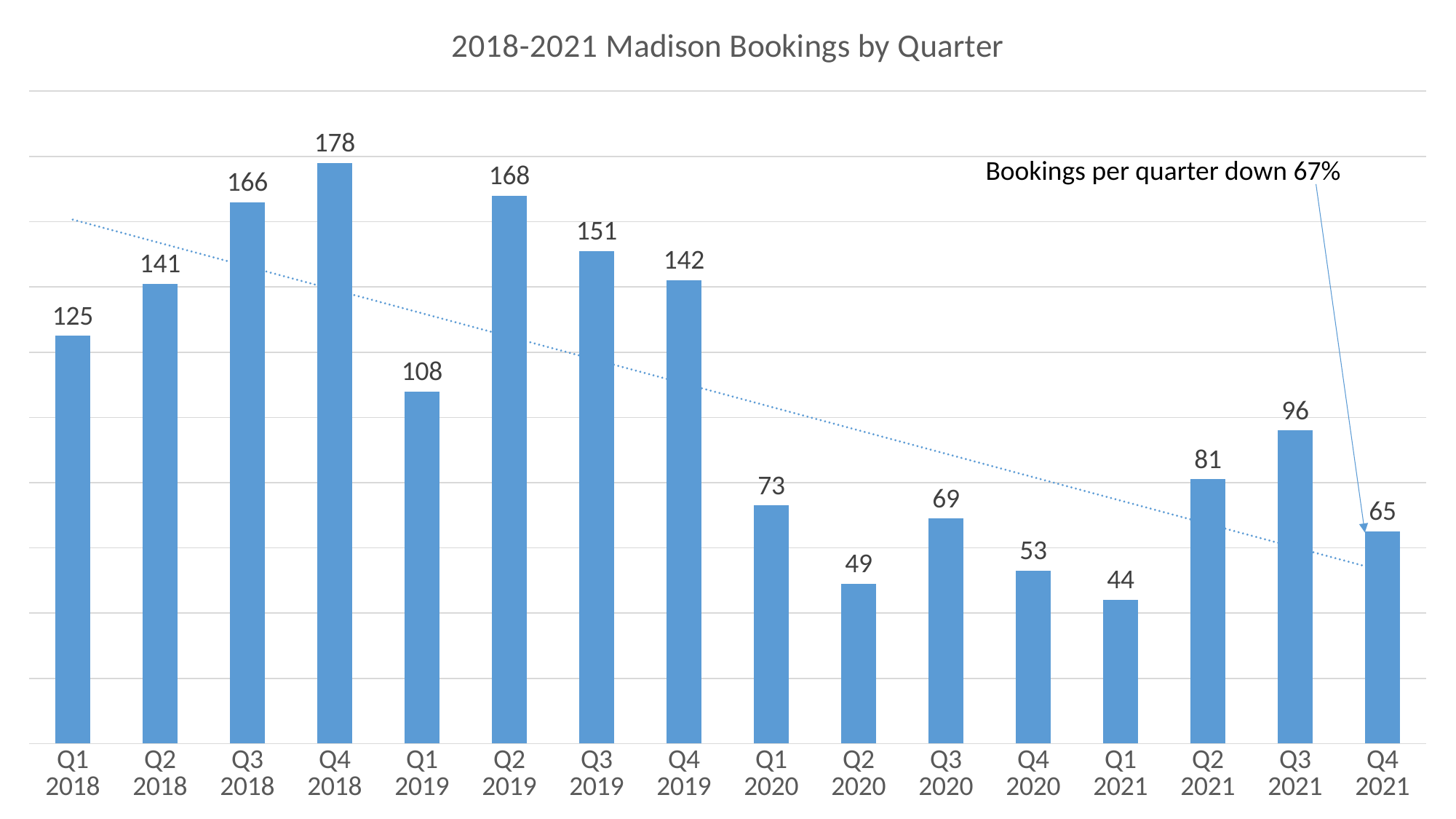
What is the difference between the bookings in Q4 2018 and Q4 2021? 113 How many quarters are shown on the chart? 16 What is the difference between the bookings in Q2 2019 and Q1 2019? 60 What is the value for Q1 2021? 44 Which quarter has the highest number of bookings? Q4 2018 What is the title of the chart? 2018-2021 Madison Bookings by Quarter What kind of chart is this? Bar chart What is the value for Q4 2018? 178 Which is larger, the value for Q3 2019 or the value for Q4 2019? Q3 2019 Does the dotted trend line rise or fall from left to right? Fall What is the value for Q3 2021? 96 Which quarter has the lowest number of bookings? Q1 2021